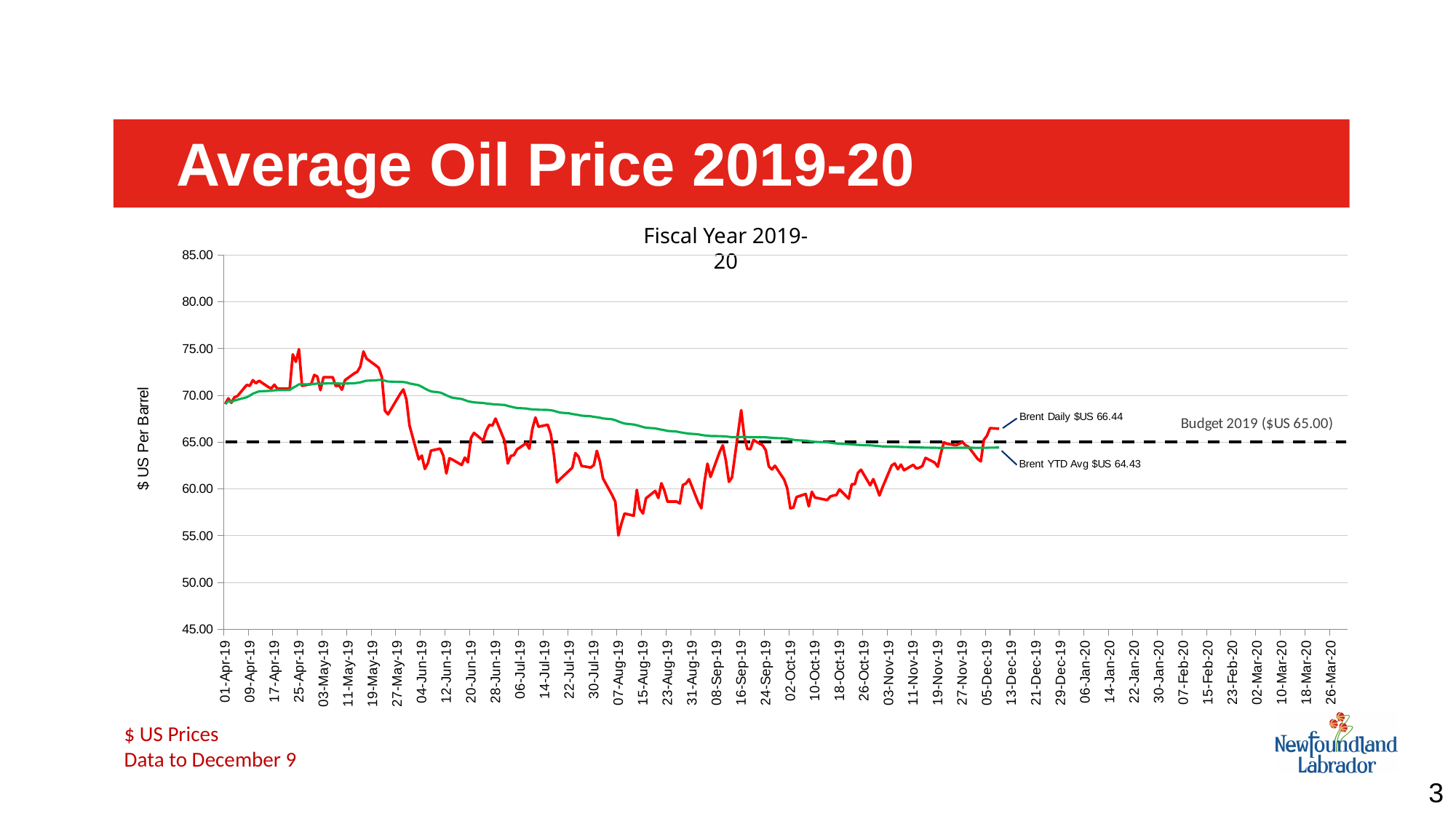
Is the Brent Daily price around 25-Apr-19 greater or less than 70.00? greater What is the difference between the Budget 2019 price and the Brent YTD Avg price? 0.57 What is the Brent Daily price labelled at the end of the plotted data? $US 66.44 How much higher is the labelled Brent Daily price than the Budget 2019 price? 1.44 What kind of chart is shown on the slide? line chart Which is larger, the Brent YTD Avg price or the Budget 2019 price? Budget 2019 What oil price does the Budget 2019 dashed line represent? $US 65.00 What is the label on the vertical axis of the chart? $ US Per Barrel What is the Brent YTD Avg price labelled on the chart? $US 64.43 Is the Brent Daily price around 07-Aug-19 greater or less than 60.00? less Which is larger, the labelled Brent Daily price or the Brent YTD Avg price? Brent Daily Does the Brent YTD Avg line rise or fall between late May 2019 and December 2019? fall